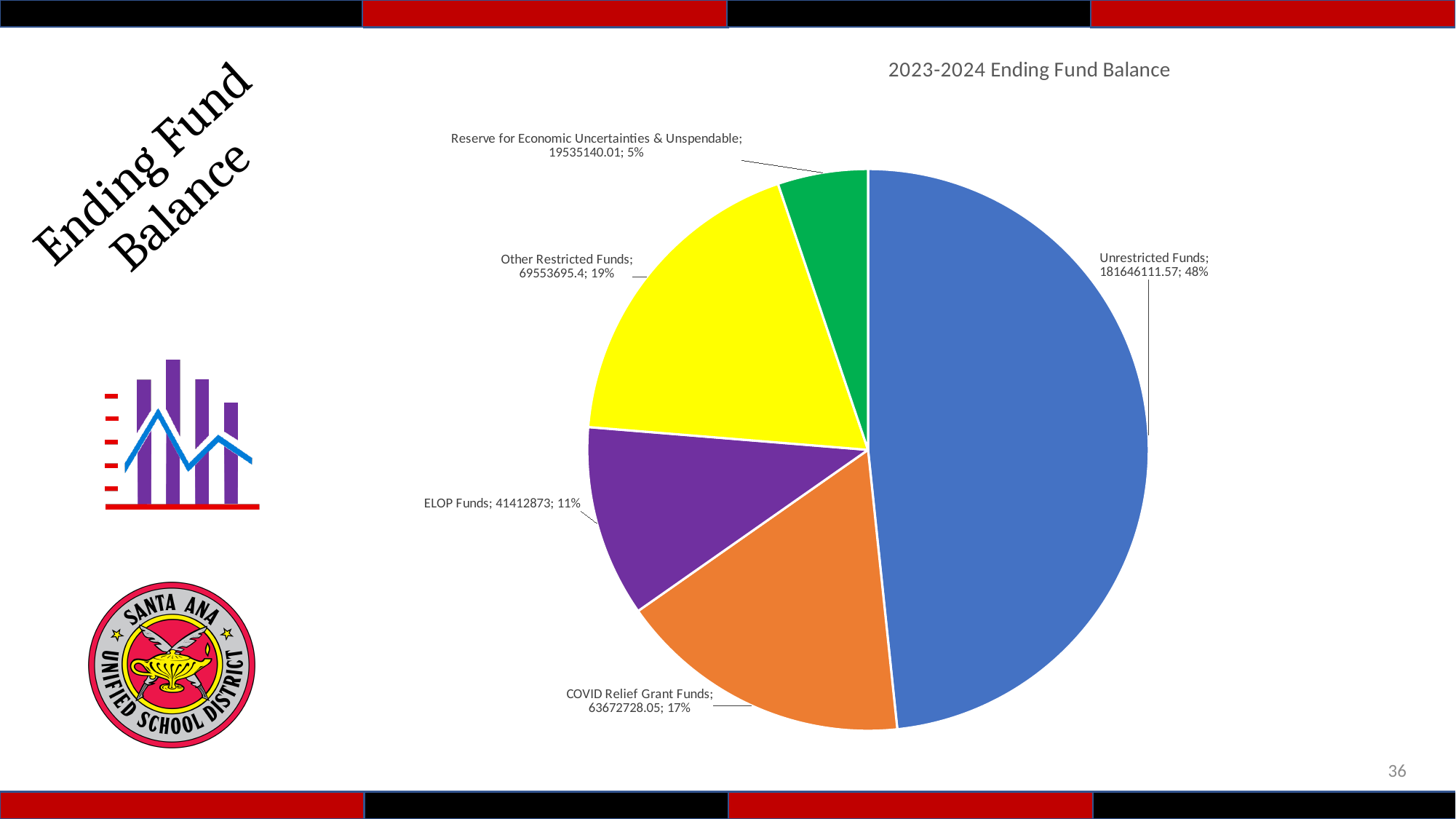
What is the title of the pie chart? 2023-2024 Ending Fund Balance What is the value shown for ELOP Funds? 41412873 Which category has the largest slice of the pie? Unrestricted Funds What is the value shown for Reserve for Economic Uncertainties & Unspendable? 19535140.01 What is the value shown for Unrestricted Funds? 181646111.57 What share of the pie is COVID Relief Grant Funds? 17% What type of chart is shown on the slide? Pie chart Which category has the smallest slice of the pie? Reserve for Economic Uncertainties & Unspendable What is the difference in percentage share between Unrestricted Funds and Other Restricted Funds? 29% What share of the pie is Other Restricted Funds? 19% How many slices does the pie chart have? 5 Which is larger, Other Restricted Funds or COVID Relief Grant Funds? Other Restricted Funds